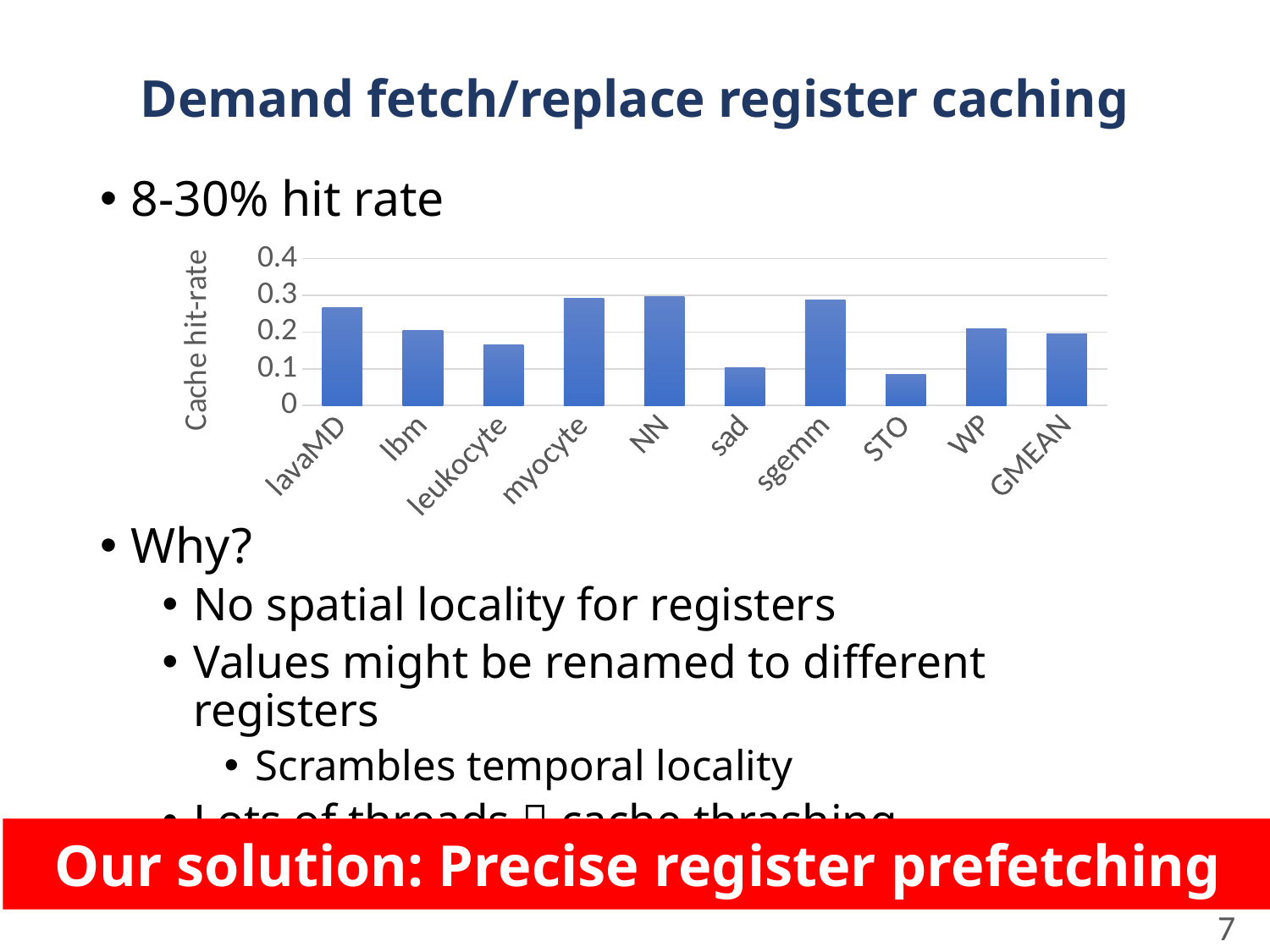
Is the value for STO greater or less than 0.1? less What is the label of the vertical axis of the chart? Cache hit-rate Is the value for lavaMD greater or less than 0.2? greater Is the value for sad greater or less than 0.2? less Which has the higher cache hit-rate, sgemm or sad? sgemm What is the highest value shown on the vertical axis of the chart? 0.4 How many categories are plotted on the x axis of the chart? 10 Which has the higher cache hit-rate, lavaMD or lbm? lavaMD Which category has the lowest cache hit-rate in the chart? STO What kind of chart is shown on the slide? bar chart